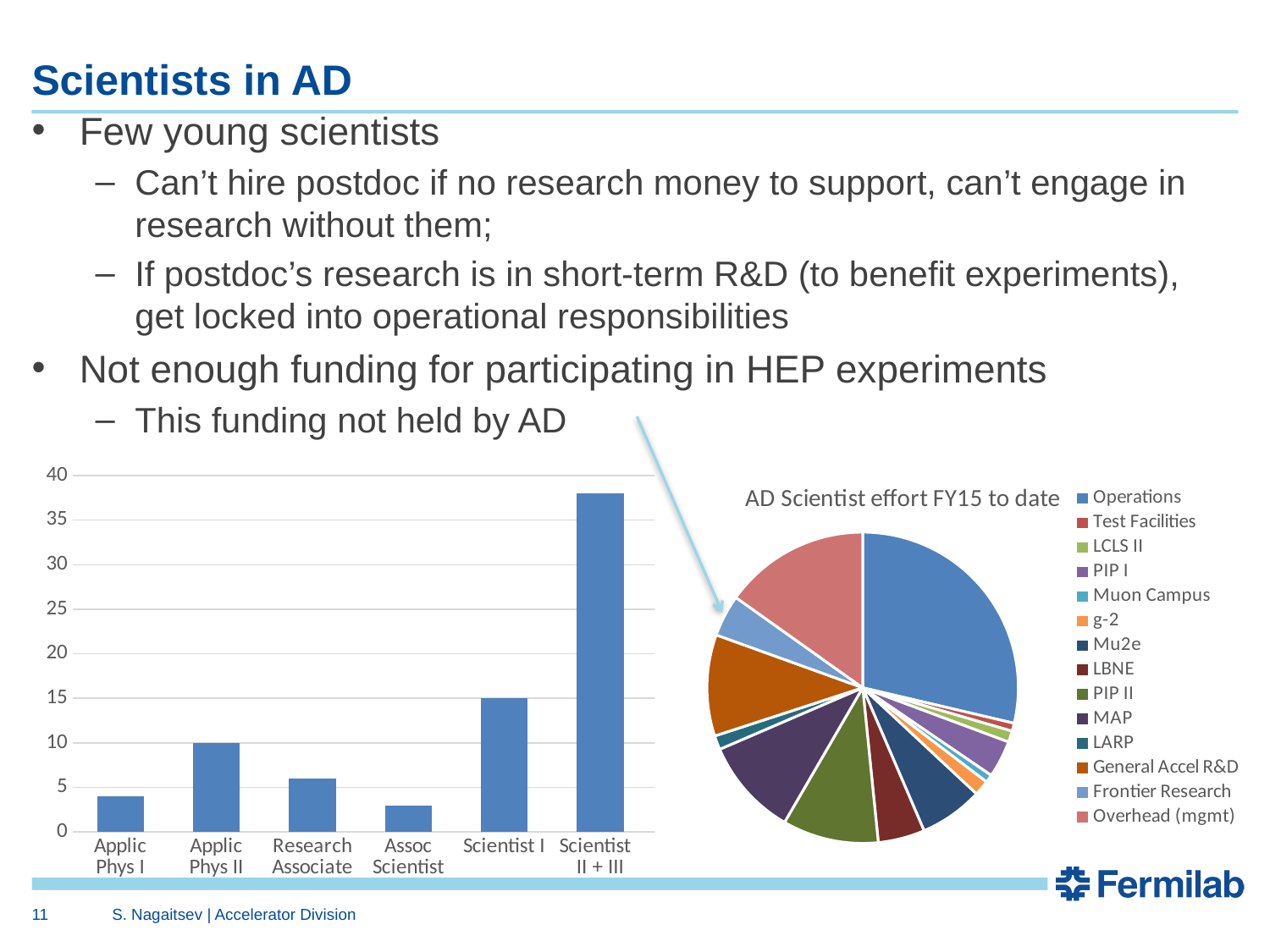
In the bar chart on the left, what is the value for Applic Phys II? 10 What is the title of the pie chart on the right of the slide? AD Scientist effort FY15 to date In the pie chart 'AD Scientist effort FY15 to date', which category has the largest slice? Operations In the bar chart on the left, is the value for Scientist II + III greater or less than 35? greater In the bar chart on the left, which category has the lowest value? Assoc Scientist How many categories does the bar chart on the left show? 6 What kind of chart is the chart on the left of the slide? bar chart In the bar chart on the left, what is the value for Scientist I? 15 How many entries does the legend of the pie chart 'AD Scientist effort FY15 to date' list? 14 In the bar chart on the left, is the value for Applic Phys I greater or less than 5? less In the bar chart on the left, which is larger: Applic Phys II or Research Associate? Applic Phys II In the bar chart on the left, which category has the highest value? Scientist II + III